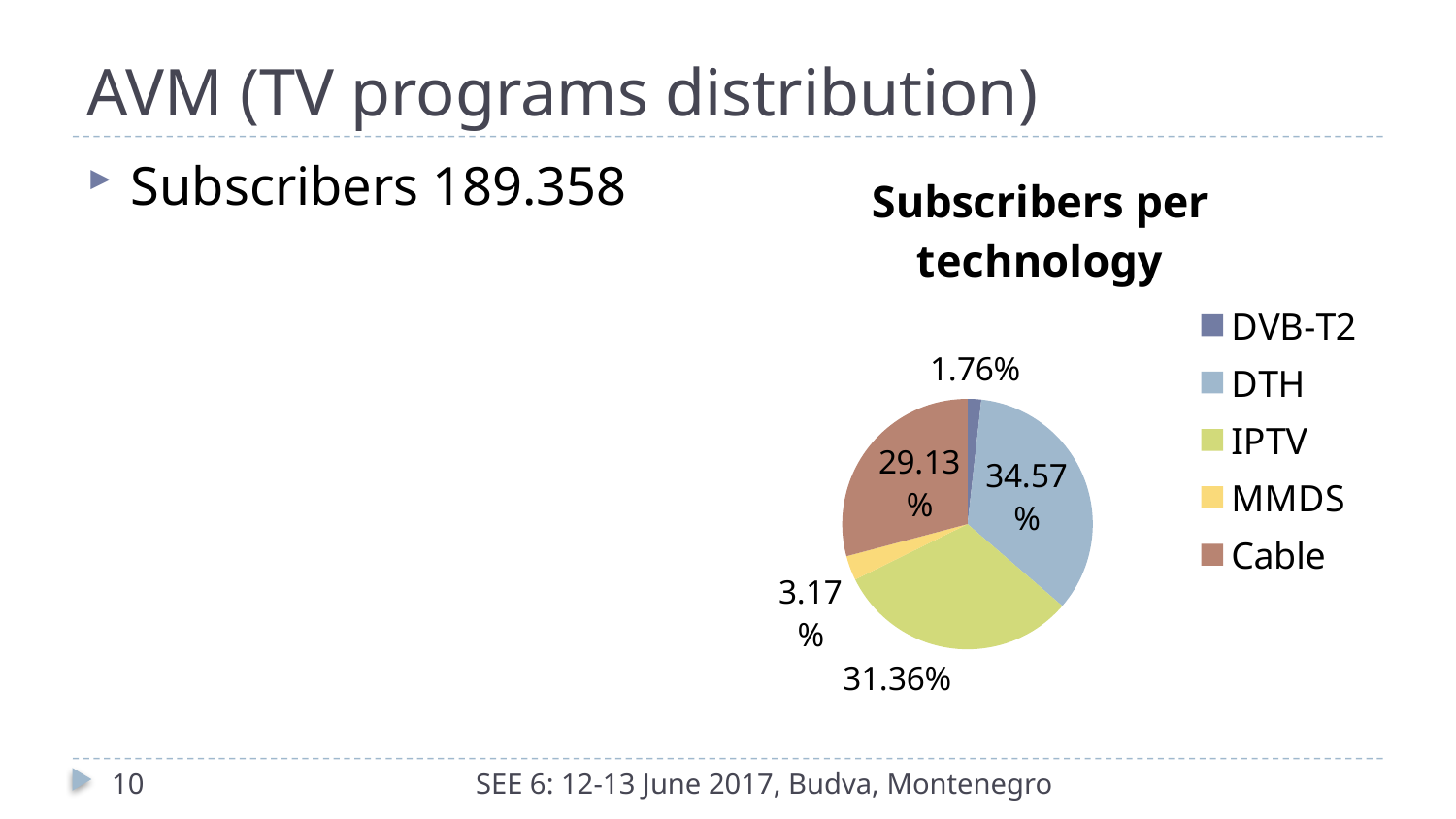
What is the title of the chart? Subscribers per technology Which technology has the smallest share of subscribers? DVB-T2 Which technology has the largest share of subscribers? DTH What share of subscribers does MMDS account for? 3.17% What share of subscribers does DTH account for? 34.57% What kind of chart is shown on the slide? pie chart What share of subscribers does DVB-T2 account for? 1.76% How many entries does the chart legend list? 5 What is the difference in percentage points between the DTH share and the IPTV share? 3.21 Which has a larger share of subscribers, IPTV or Cable? IPTV